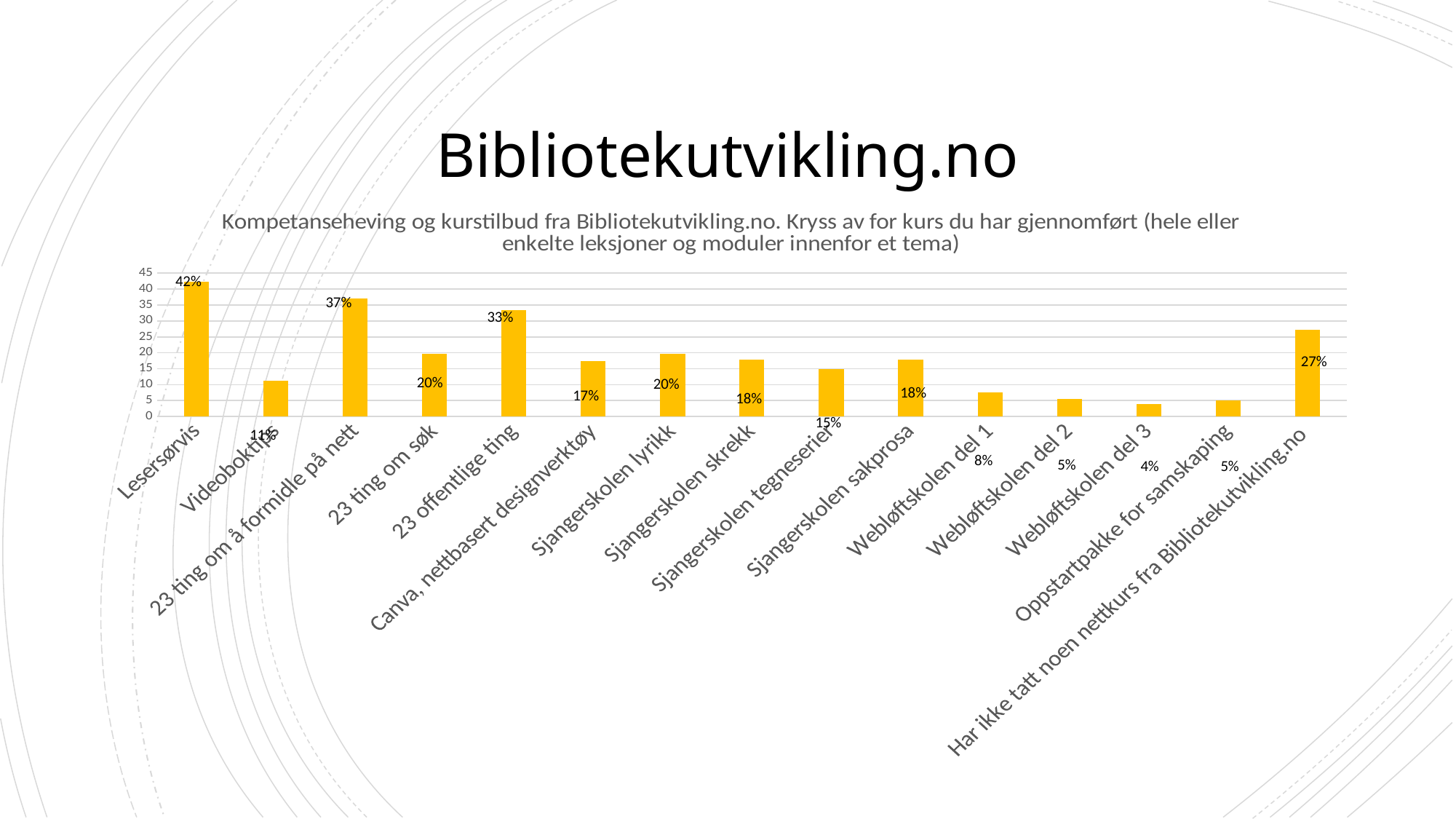
What is the value for Har ikke tatt noen nettkurs fra Bibliotekutvikling.no? 27% Which category has the lowest value? Webløftskolen del 3 What is the value for Sjangerskolen tegneserier? 15% What is the value for Lesersørvis? 42% Which category has the highest value? Lesersørvis What is the value for 23 offentlige ting? 33% What is the difference between the values for Lesersørvis and 23 ting om å formidle på nett? 5% Is the value for 23 ting om å formidle på nett greater or less than 30? greater Which is larger, the value for Videoboktips or the value for Canva, nettbasert designverktøy? Canva, nettbasert designverktøy What colour are the bars in the chart? Yellow How many categories are shown on the x axis? 15 What kind of chart is shown on the slide? Bar chart